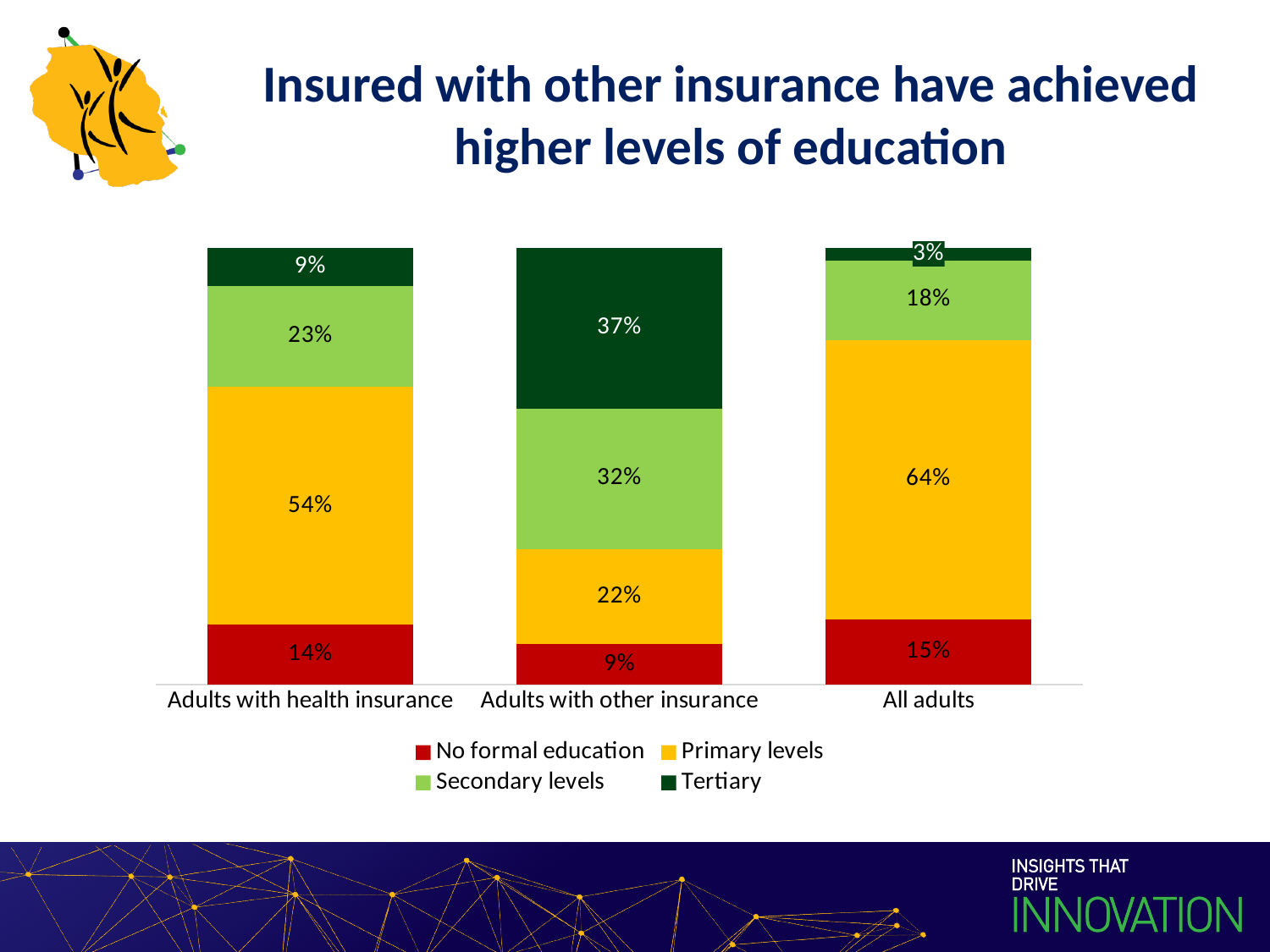
Which colour represents the Tertiary series in the chart? Dark green What percentage of adults with health insurance have primary levels of education? 54% What percentage of adults with other insurance have tertiary education? 37% What percentage of adults with other insurance have secondary levels of education? 32% How many categories are shown on the x axis? 3 What kind of chart is shown on the slide? Stacked bar chart Which category has the highest share of tertiary education? Adults with other insurance Which category has the lowest share of no formal education? Adults with other insurance What percentage of all adults have no formal education? 15% What is the difference in the primary levels share between all adults and adults with other insurance? 42% Which is larger: the secondary levels share for adults with health insurance or for all adults? Adults with health insurance How many series does the legend list? 4